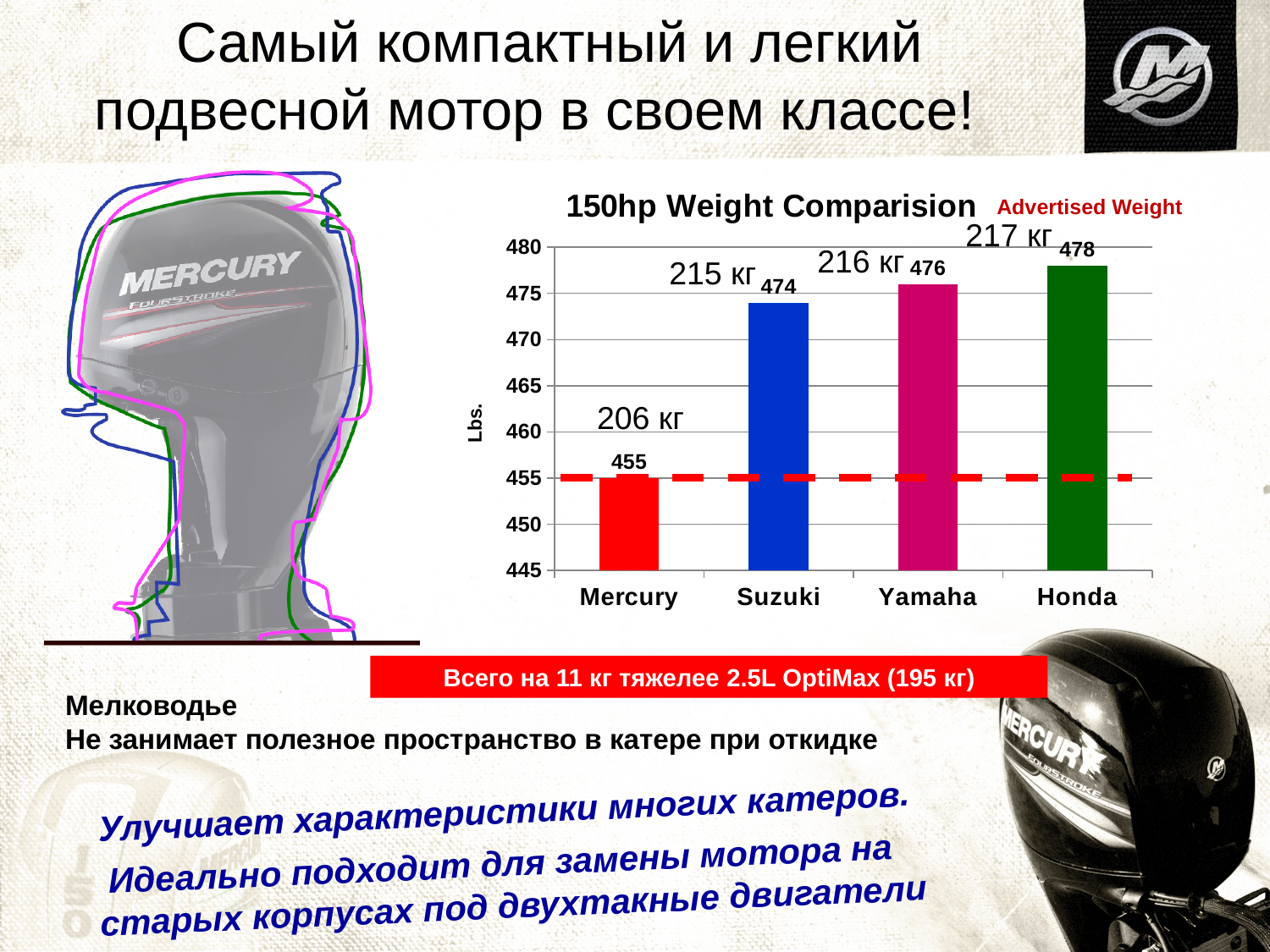
What is the value for Yamaha in the 150hp Weight Comparision chart? 476 What is the value for Suzuki in the 150hp Weight Comparision chart? 474 How many categories are shown in the 150hp Weight Comparision chart? 4 Which category has the lowest value in the 150hp Weight Comparision chart? Mercury What kind of chart is the 150hp Weight Comparision chart? bar chart Do the values rise or fall from left to right across the categories in the 150hp Weight Comparision chart? rise What is the difference between the Honda and Mercury values in the 150hp Weight Comparision chart? 23 What is the value for Honda in the 150hp Weight Comparision chart? 478 Which category has the highest value in the 150hp Weight Comparision chart? Honda What is the value for Mercury in the 150hp Weight Comparision chart? 455 Which is larger in the 150hp Weight Comparision chart, the value for Suzuki or the value for Mercury? Suzuki What is the label on the vertical axis of the 150hp Weight Comparision chart? Lbs.